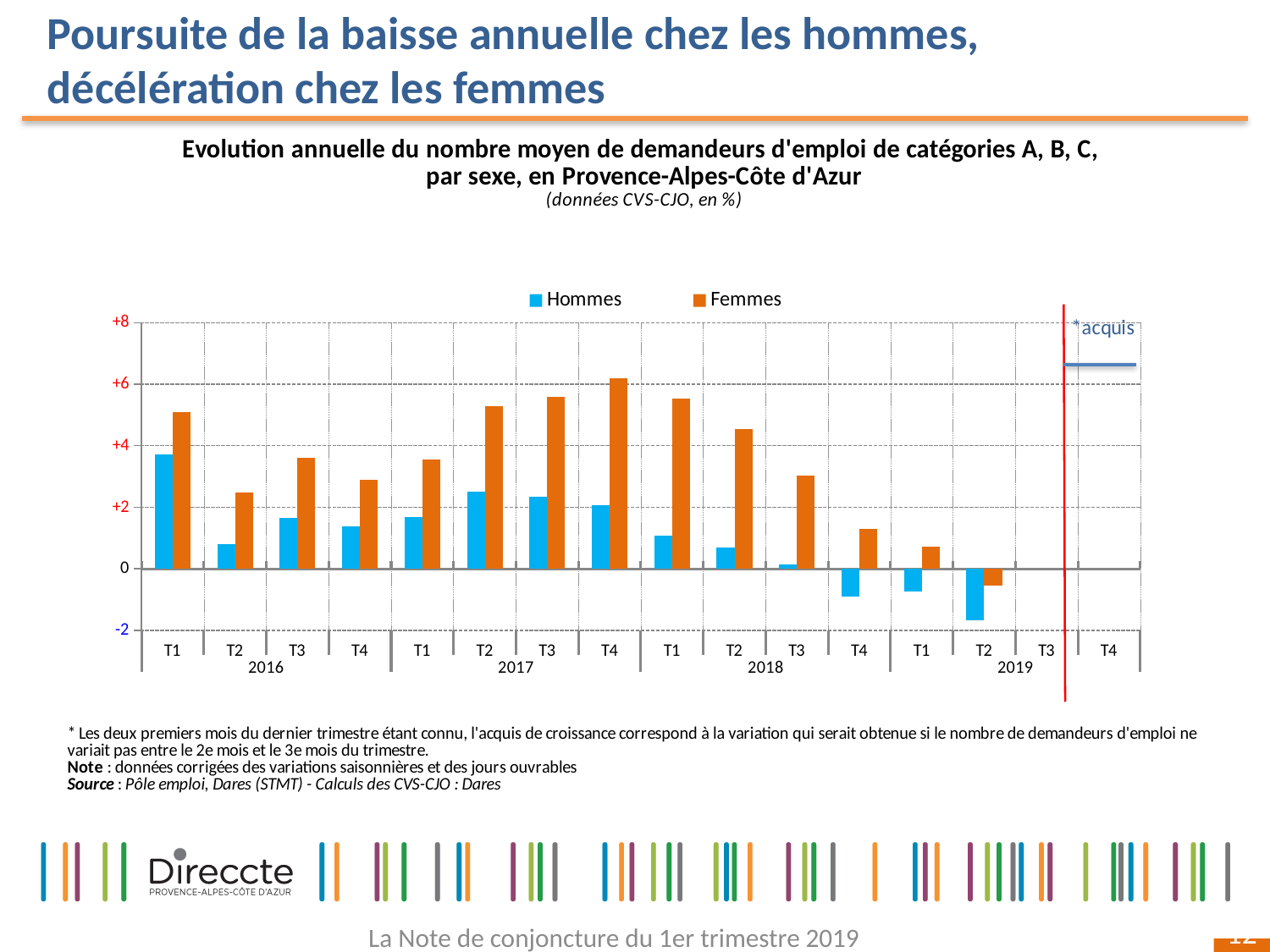
What kind of chart is shown on the slide? Bar chart In which quarter does the Hommes series reach its lowest value? T2 2019 How many series does the legend list? 2 In T1 2016, which series has the larger value, Hommes or Femmes? Femmes Which series is shown in orange in the legend? Femmes Do the Hommes values rise or fall from T1 2018 to T2 2019? Fall Is the value for Hommes in T2 2019 greater or less than 0? less Is the value for Hommes in T1 2016 greater or less than +2? greater Is the value for Femmes in T4 2017 greater or less than +4? greater In which quarter does the Hommes series reach its highest value? T1 2016 How many years are labelled along the x axis? 4 In which quarter does the Femmes series reach its highest value? T4 2017